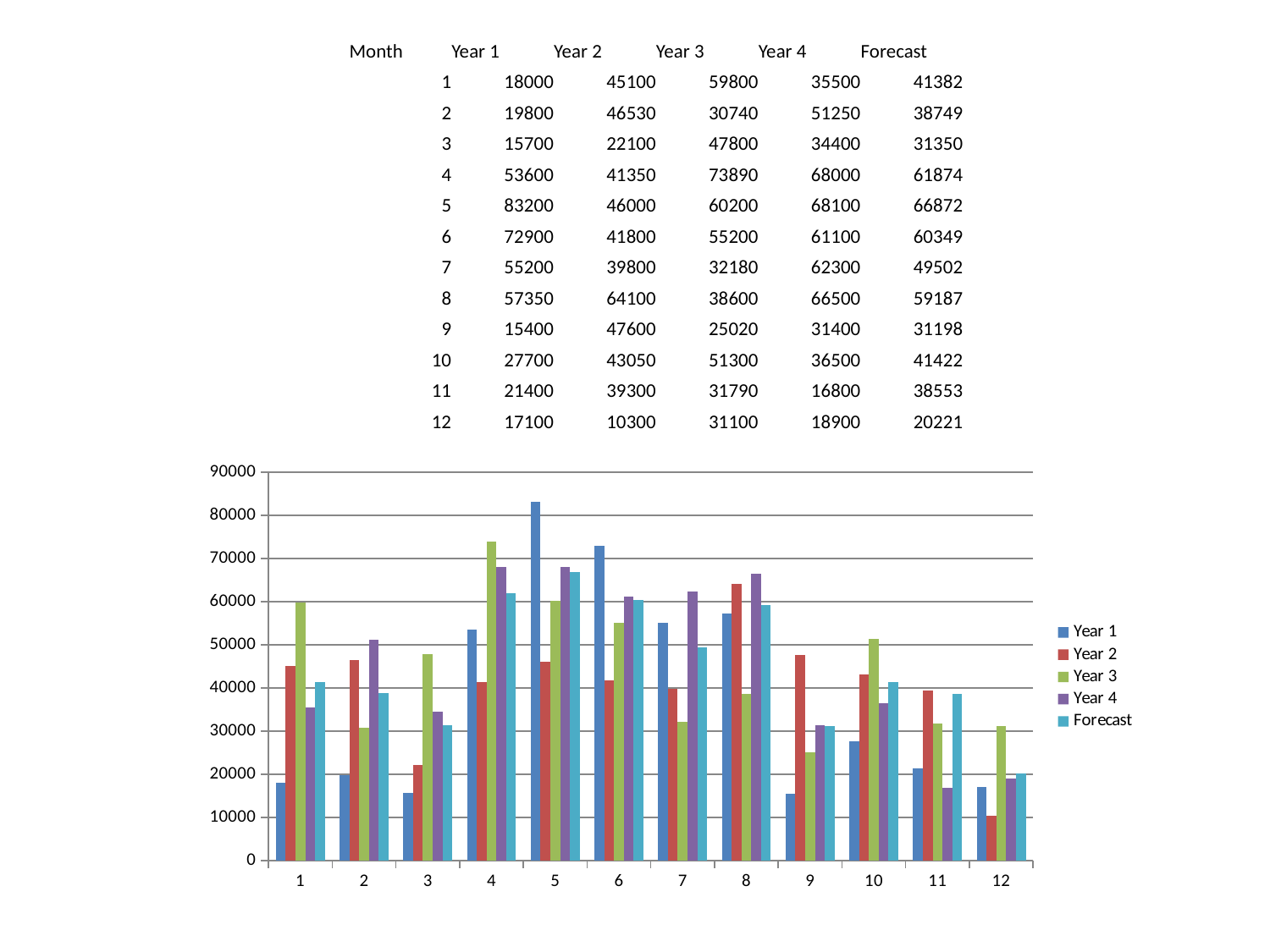
What is the difference between the Year 4 value and the Year 1 value in month 1? 17500 Which series is shown in blue in the chart legend? Year 1 What is the Year 3 value for month 4? 73890 What is the Forecast value for month 12? 20221 Is the Year 1 value for month 6 greater or less than 70000? greater What type of chart is shown on the slide? bar chart Which is larger in month 9: the Year 2 value or the Year 4 value? Year 2 How many months are shown along the x axis of the chart? 12 What is the Year 1 value for month 5? 83200 How many series does the chart legend list? 5 In which month is the Year 2 value lowest? 12 In which month is the Year 1 value highest? 5